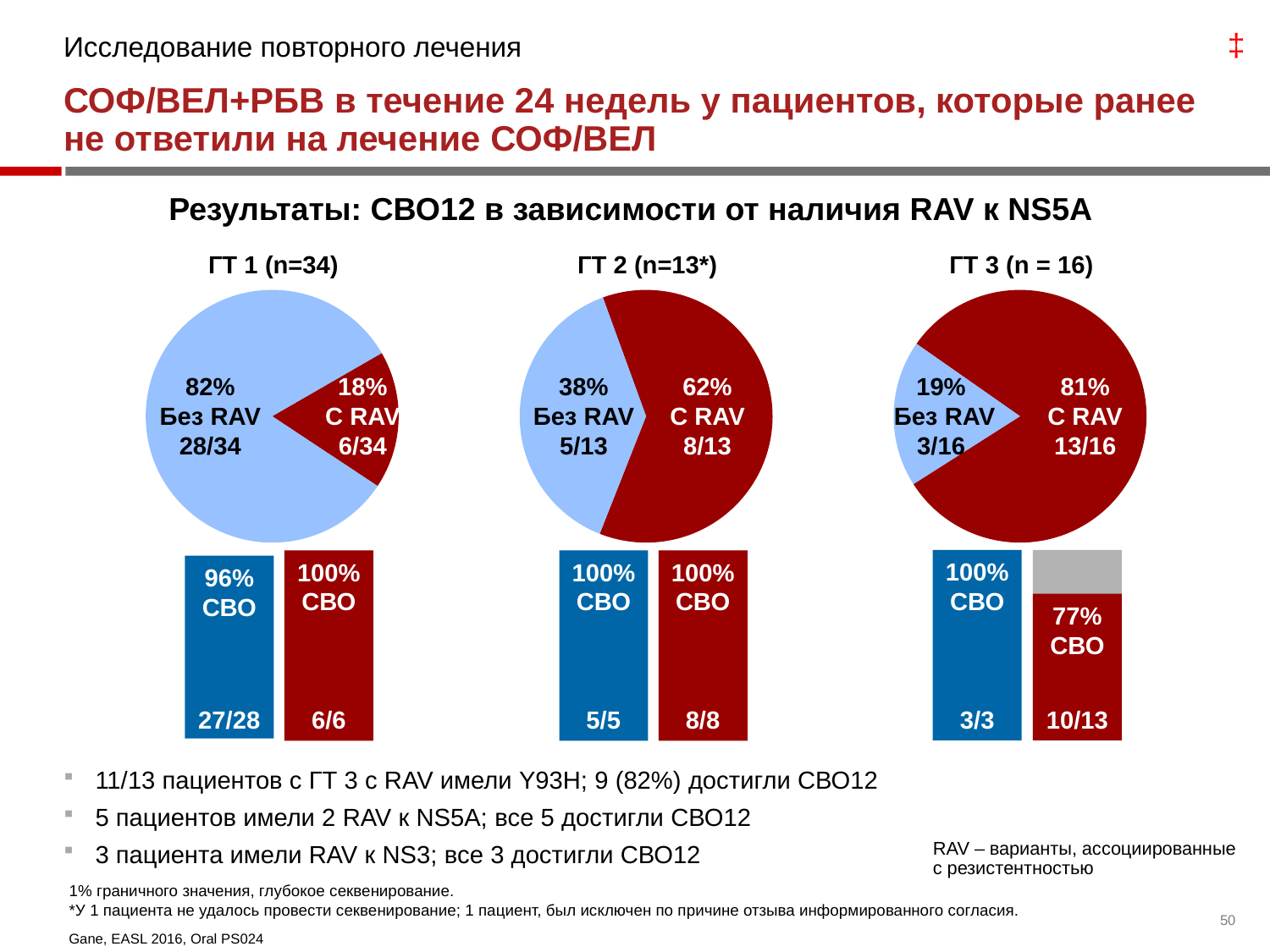
In the ГТ 2 (n=13*) pie chart, which slice is smaller: Без RAV or С RAV? Без RAV In the ГТ 1 (n=34) pie chart, what share of patients had no RAV (Без RAV)? 82% In the ГТ 2 (n=13*) pie chart, what share of patients had RAV (С RAV)? 62% In the ГТ 3 (n = 16) pie chart, how many patients had no RAV (Без RAV)? 3/16 What type of charts are shown in the top row of the slide? Pie charts How many pie charts are shown on the slide? 3 In the ГТ 1 (n=34) pie chart, what share of patients had RAV (С RAV)? 18% In the bar chart under ГТ 1 (n=34), what is the СВО rate for patients without RAV? 96% In the bar chart under ГТ 3 (n = 16), how many patients with RAV achieved СВО? 10/13 In the bar chart under ГТ 3 (n = 16), what is the СВО rate for patients with RAV? 77% In the ГТ 3 (n = 16) pie chart, which slice is larger: Без RAV or С RAV? С RAV In the bar chart under ГТ 3 (n = 16), what is the difference in СВО rate between patients without RAV and patients with RAV? 23%